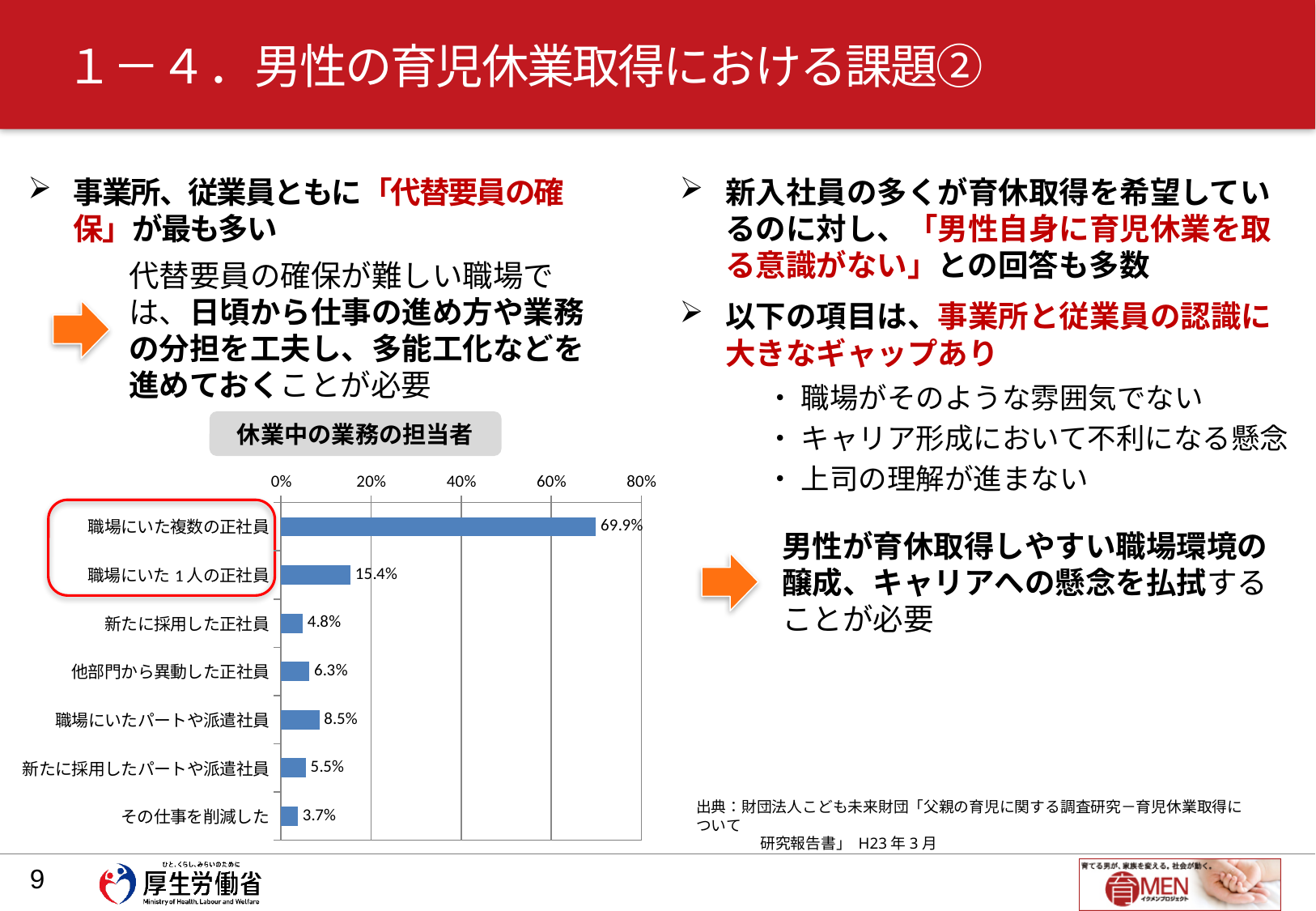
Which category has the highest value? 職場にいた複数の正社員 What is the value for 職場にいた１人の正社員? 15.4% What is the value for その仕事を削減した? 3.7% What is the value for 職場にいた複数の正社員? 69.9% Which is larger, the value for 他部門から異動した正社員 or the value for 新たに採用した正社員? 他部門から異動した正社員 How many categories are shown in the chart? 7 What kind of chart is shown on the slide? bar chart Is the value for 職場にいた複数の正社員 greater or less than 60%? greater What is the title of the chart? 休業中の業務の担当者 Which category has the lowest value? その仕事を削減した What is the difference between the values for 職場にいた複数の正社員 and 職場にいた１人の正社員? 54.5% What is the value for 職場にいたパートや派遣社員? 8.5%